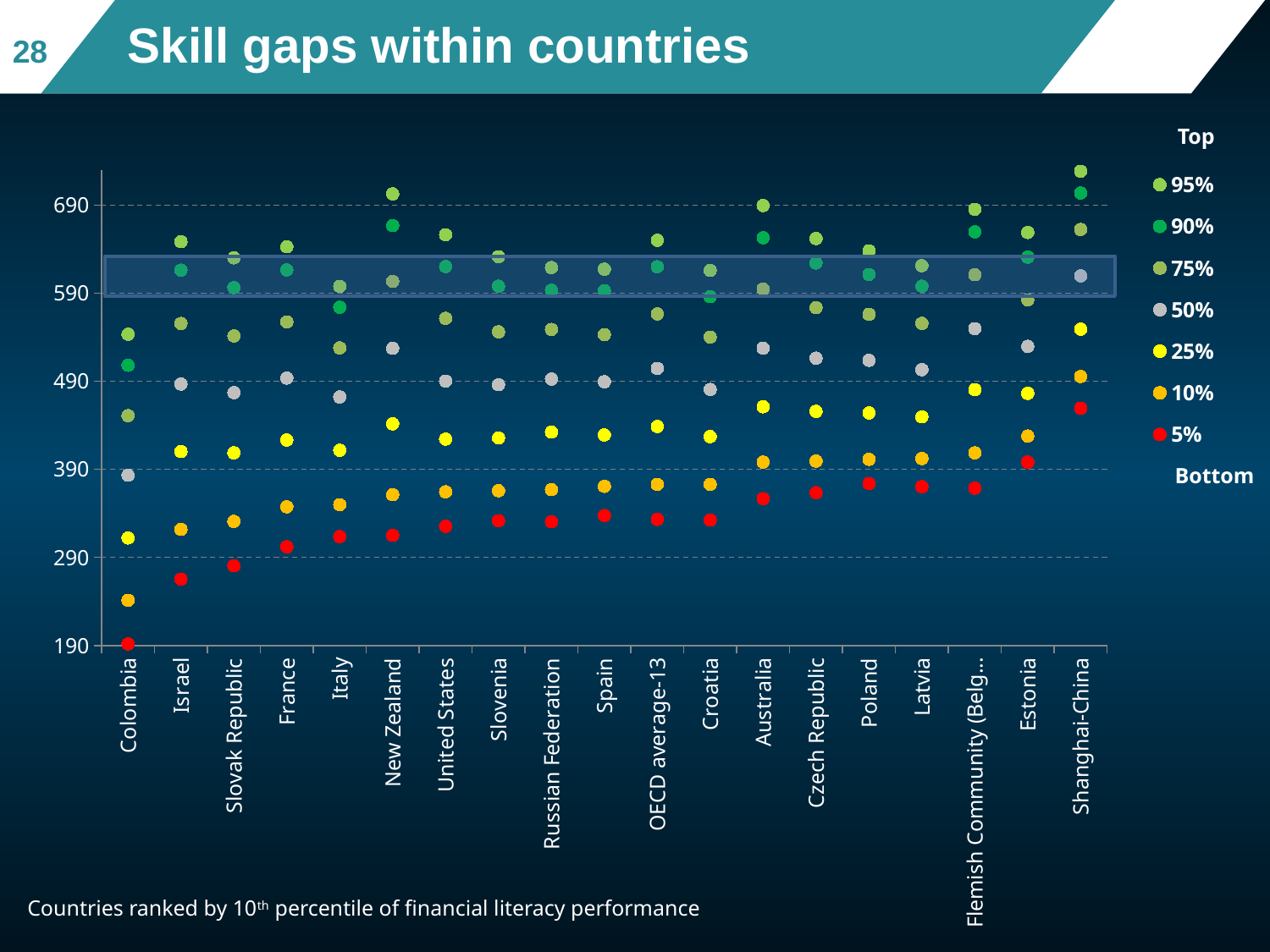
What kind of chart is shown on the slide? Dot (scatter) chart What colour are the 5% percentile markers? Red Which country has the lowest 5% percentile value? Colombia How many countries or categories are shown along the x axis? 19 How many series does the legend list? 7 Which country has the highest 95% percentile value? Shanghai-China Which country has the lowest 10% percentile value? Colombia Is the 25% value for Colombia greater or less than 390? less Is the 95% value for Shanghai-China greater or less than 690? greater Do the 10% percentile values rise or fall moving from left to right along the x axis? rise Which is larger, the 50% value for Shanghai-China or the 50% value for Colombia? Shanghai-China Is the 5% value for Israel greater or less than 290? less